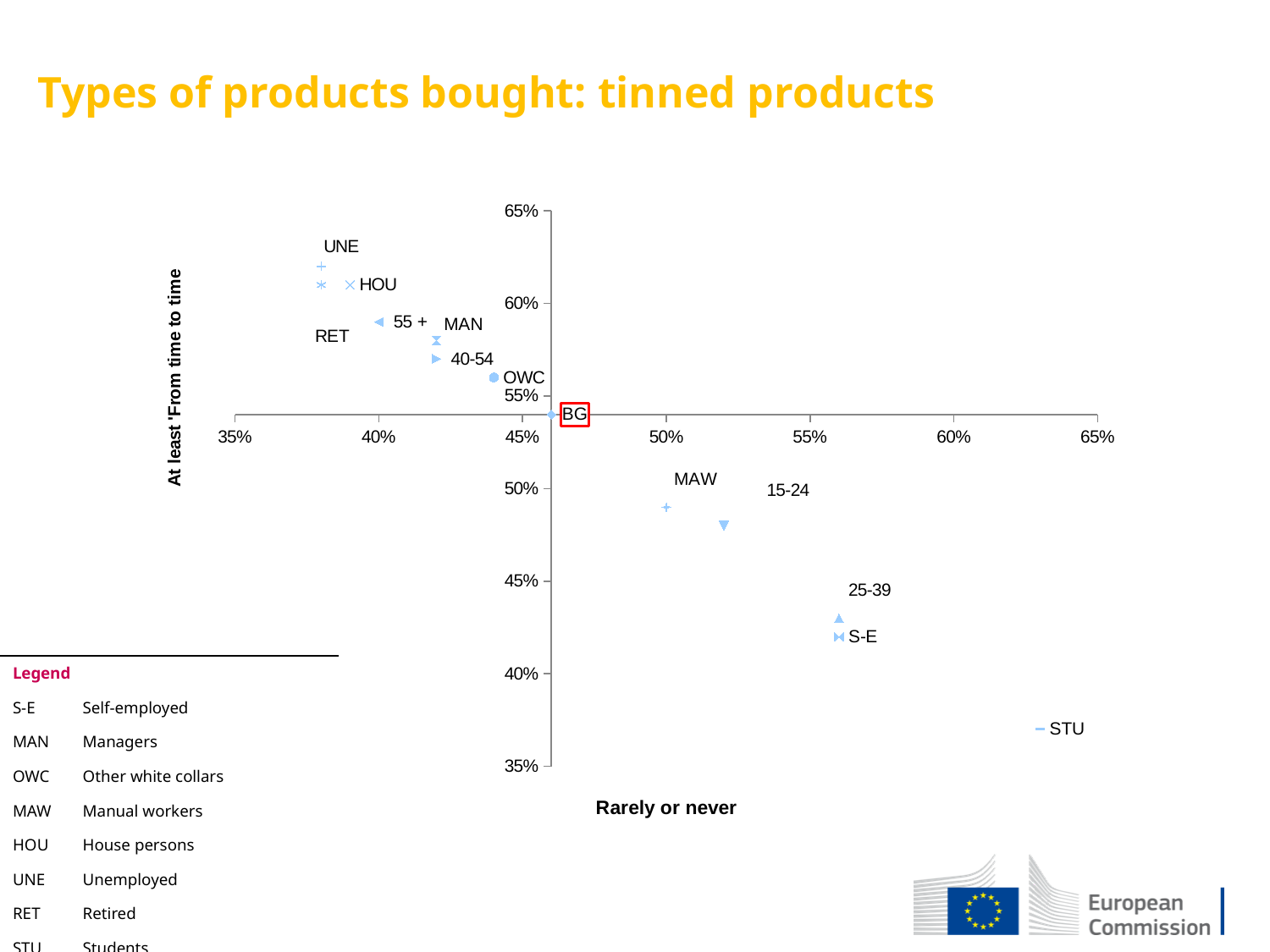
Which group has the highest 'At least From time to time' value? UNE What is the title of the chart? Types of products bought: tinned products What is the label of the horizontal axis? Rarely or never Is the 'At least From time to time' value for STU greater or less than 40%? less Is the 'At least From time to time' value for 25-39 greater or less than 45%? less Which group has the lowest 'At least From time to time' value? STU Is the 'At least From time to time' value for UNE greater or less than 60%? greater What kind of chart is shown on the slide? scatter chart How many labelled data points are plotted on the chart? 13 Which group has the highest 'Rarely or never' value? STU